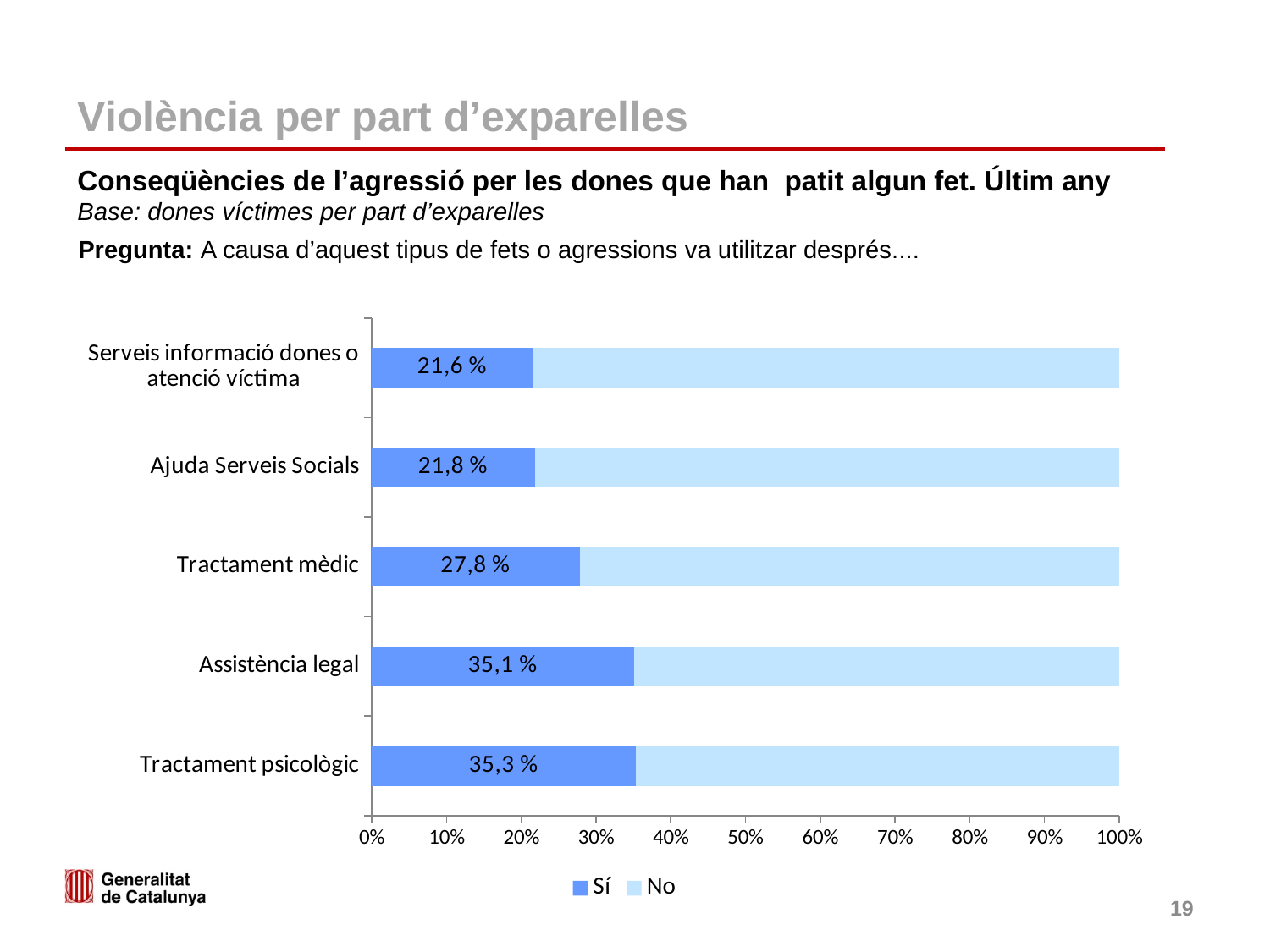
How many categories are shown on the chart? 5 What is the 'Sí' value for Serveis informació dones o atenció víctima? 21,6 % Which has a larger 'Sí' value, Assistència legal or Tractament mèdic? Assistència legal What is the difference between the 'Sí' values for Tractament psicològic and Serveis informació dones o atenció víctima? 13,7 % Is the 'Sí' value for Tractament mèdic greater or less than 30%? less What is the 'Sí' value for Ajuda Serveis Socials? 21,8 % What is the 'Sí' value for Tractament psicològic? 35,3 % What is the 'Sí' value for Tractament mèdic? 27,8 % What is the 'Sí' value for Assistència legal? 35,1 % How many series does the legend list? 2 Which category has the highest 'Sí' value? Tractament psicològic Which category has the lowest 'Sí' value? Serveis informació dones o atenció víctima